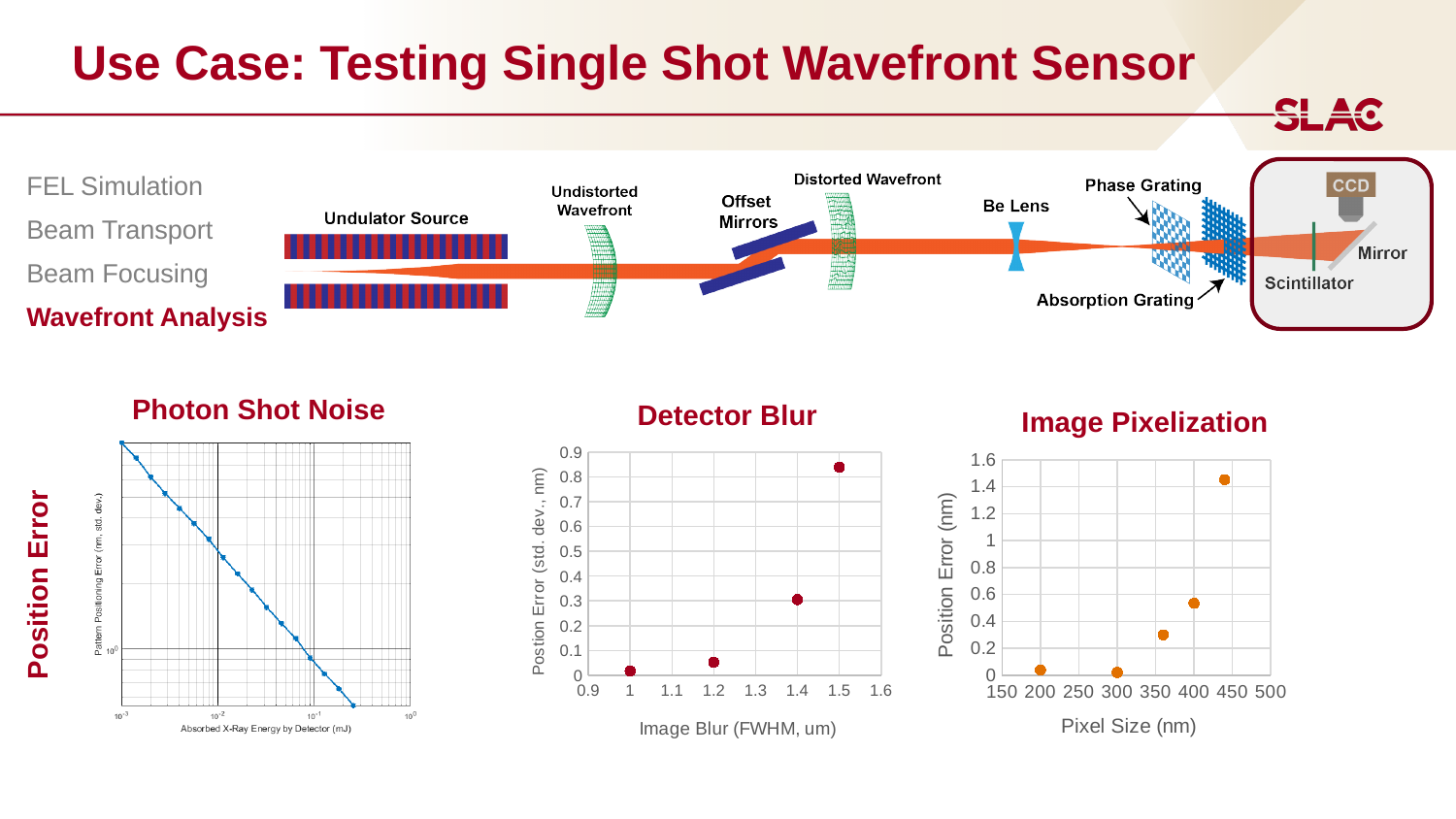
In the Photon Shot Noise chart, does the positioning error rise or fall as absorbed X-ray energy increases? fall In the Image Pixelization chart, is the position error at a pixel size of 400 nm greater or less than 0.4? greater In the Image Pixelization chart, is the position error at a pixel size of 300 nm greater or less than 0.2? less In the Image Pixelization chart, how many data points are plotted? 5 What is the x-axis label of the Image Pixelization chart? Pixel Size (nm) In the Detector Blur chart, is the position error at an image blur of 1 um greater or less than 0.1? less How many charts are shown on the slide? 3 In the Detector Blur chart, do the position error values rise or fall as image blur increases? rise What kind of chart is the Detector Blur chart? scatter chart In the Detector Blur chart, how many data points are plotted? 4 In the Detector Blur chart, which has the larger position error: the point at image blur 1.4 um or the point at 1.5 um? 1.5 um